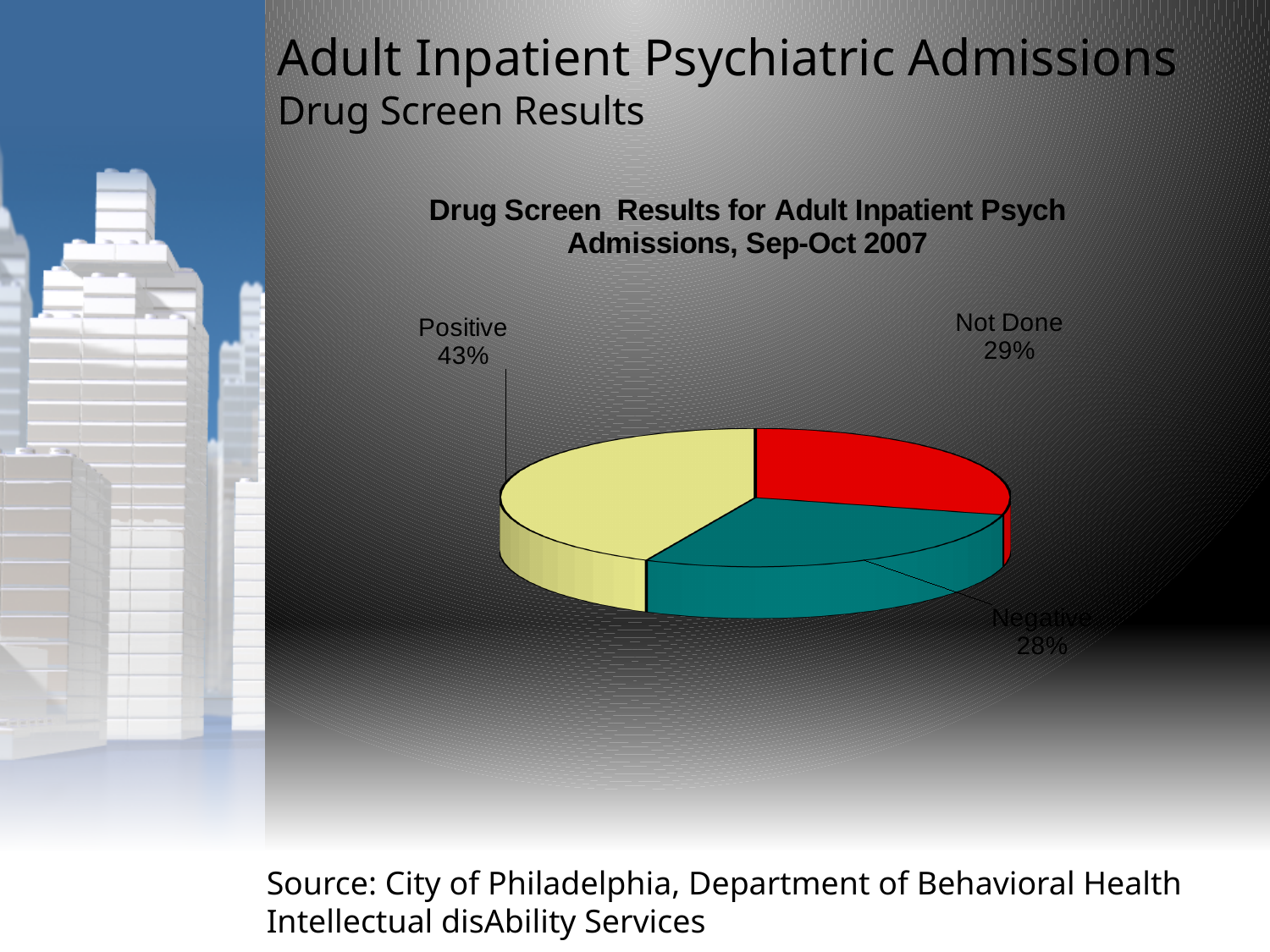
Which is larger, the Not Done share or the Negative share? Not Done What is the difference in percentage points between the Positive and Negative slices? 15 What percentage of drug screen results were Negative? 28% How many slices does the pie chart have? 3 What percentage of drug screen results were Positive? 43% What percentage of drug screen results were Not Done? 29% Which category has the largest share of the pie? Positive What is the title of the chart? Drug Screen Results for Adult Inpatient Psych Admissions, Sep-Oct 2007 What kind of chart is shown on the slide? Pie chart What colour is the Positive slice of the pie? Yellow Which category has the smallest share of the pie? Negative What is the combined share of the Not Done and Negative slices? 57%